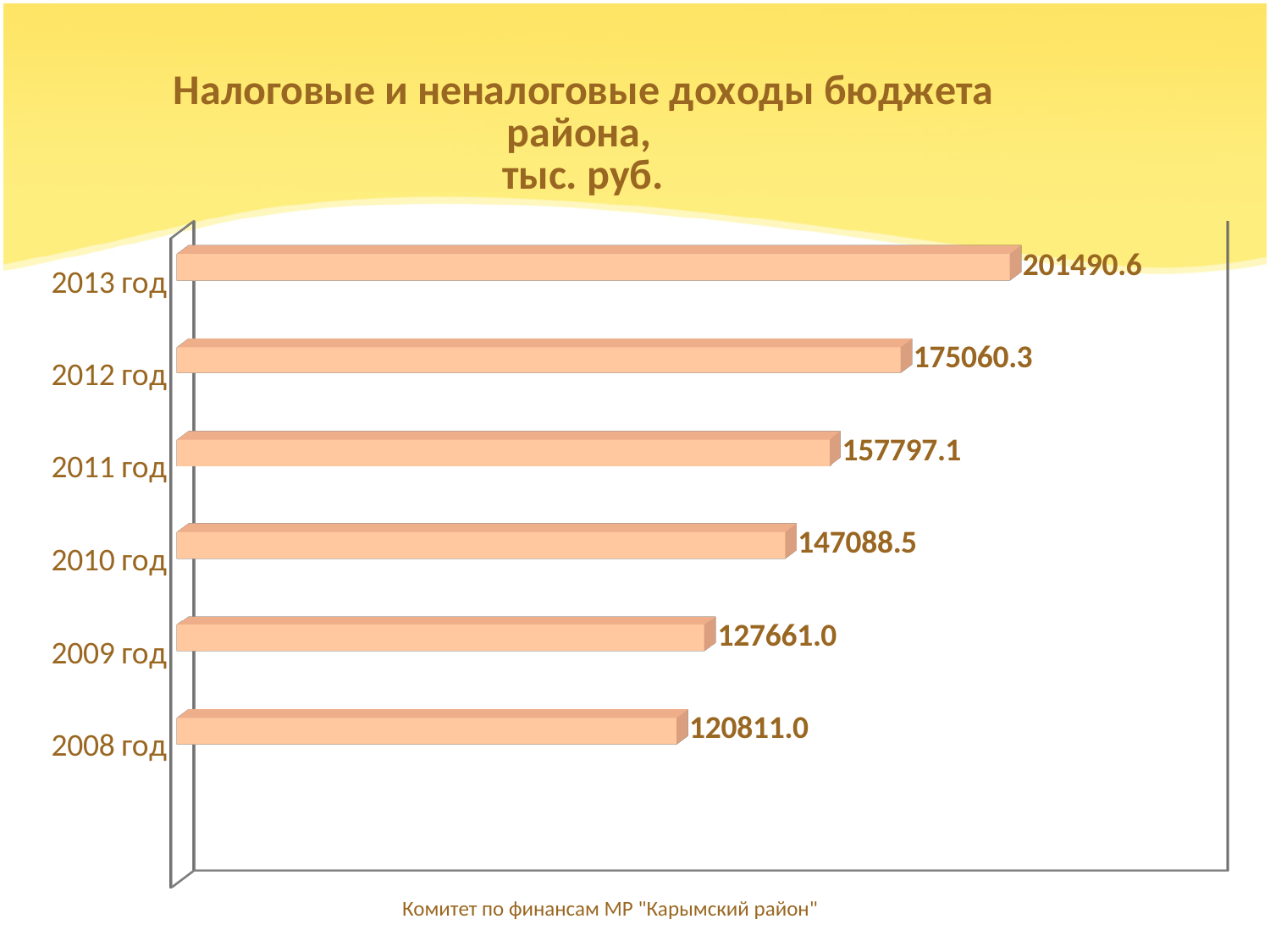
Which year has the lowest value? 2008 год What is the value for 2010 год? 147088.5 What is the value for 2013 год? 201490.6 Do the values rise or fall from 2008 год to 2013 год? rise What is the difference between the values for 2013 год and 2012 год? 26430.3 How many years are shown in the chart? 6 What is the difference between the values for 2013 год and 2008 год? 80679.6 What is the value for 2008 год? 120811.0 What is the difference between the values for 2009 год and 2008 год? 6850.0 Which is larger, the value for 2011 год or the value for 2010 год? 2011 год What kind of chart is shown on the slide? bar chart Which year has the highest value? 2013 год